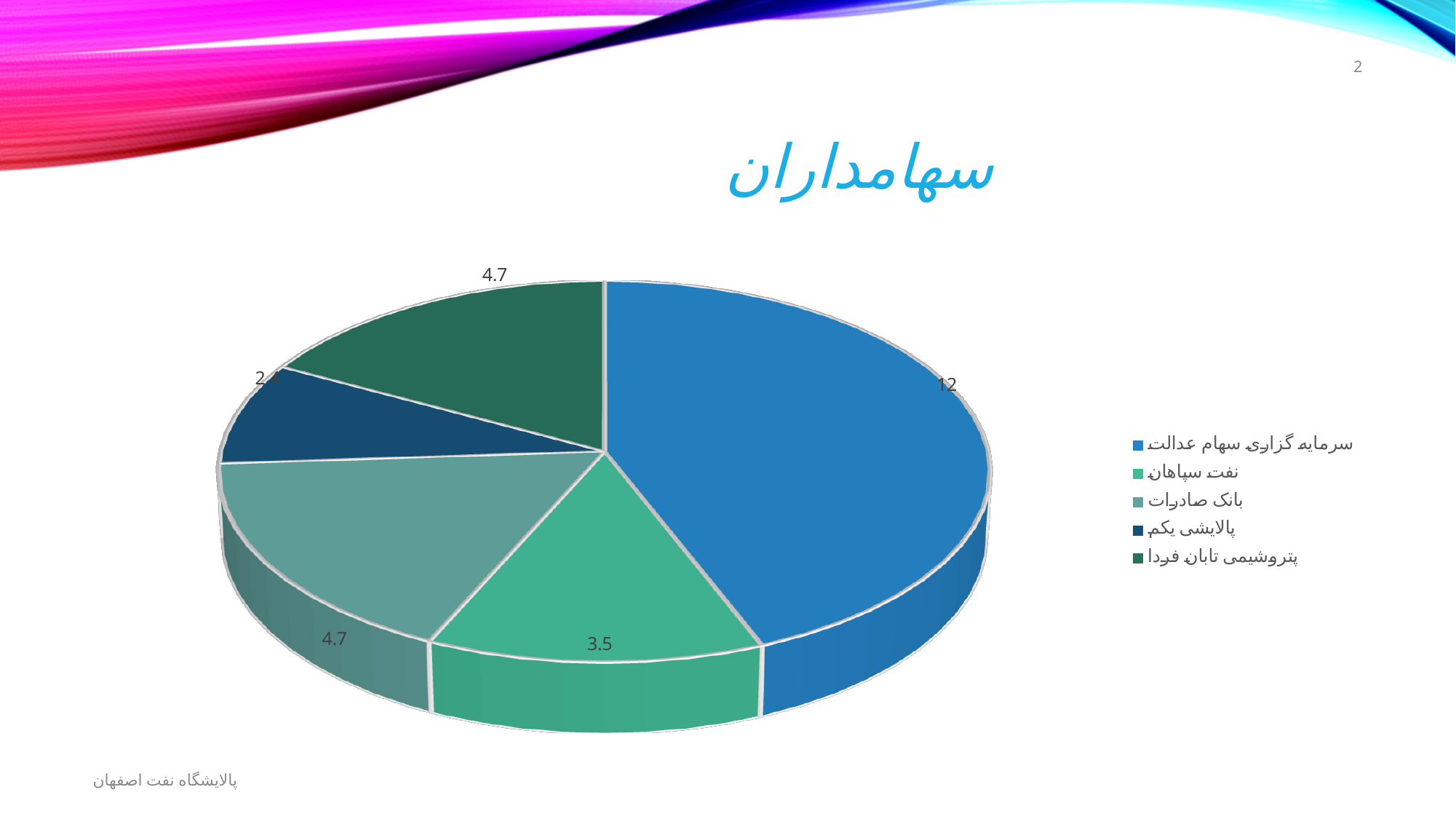
What is the value for سرمایه گزاری سهام عدالت? 12 What is the value for بانک صادرات? 4.7 What is the value for پتروشیمی تابان فردا? 4.7 How many entries does the legend list? 5 What is the value for نفت سپاهان? 3.5 Which category has the smallest slice? پالایشی یکم Which category has the largest slice? سرمایه گزاری سهام عدالت How many slices does the pie chart have? 5 Which is larger, the value for بانک صادرات or the value for نفت سپاهان? بانک صادرات What kind of chart is shown on the slide? pie chart What is the title of the chart? سهامداران What is the difference between the values for سرمایه گزاری سهام عدالت and نفت سپاهان? 8.5